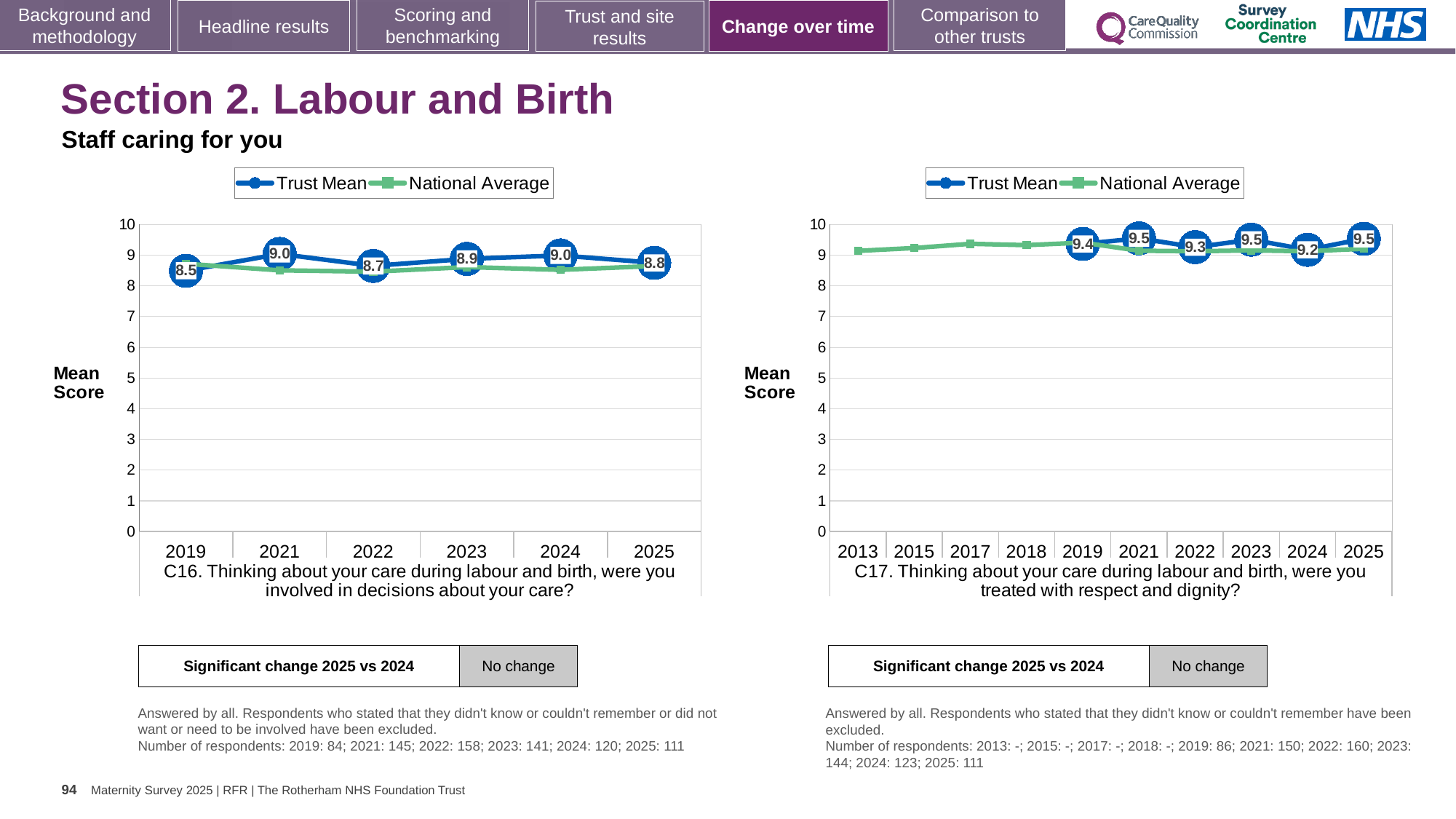
How many years are shown on the x axis of the C17 chart on the right? 10 How many series does the legend of the C16 chart on the left list? 2 How many years are shown on the x axis of the C16 chart on the left? 6 In the C17 chart on the right, which year has the lowest Trust Mean score? 2024 In the C17 chart on the right, what is the Trust Mean score for 2024? 9.2 What kind of chart is the C16 chart on the left? Line chart In the C16 chart on the left, which year has the lowest Trust Mean score? 2019 In the C16 chart on the left, what is the Trust Mean score for 2019? 8.5 In the C16 chart on the left, what is the Trust Mean score for 2025? 8.8 In the C16 chart on the left, what is the difference between the Trust Mean scores for 2021 and 2019? 0.5 In the C17 chart on the right, which year has the higher Trust Mean score, 2022 or 2023? 2023 In the C16 chart on the left, is the National Average value for 2019 greater or less than 8? greater